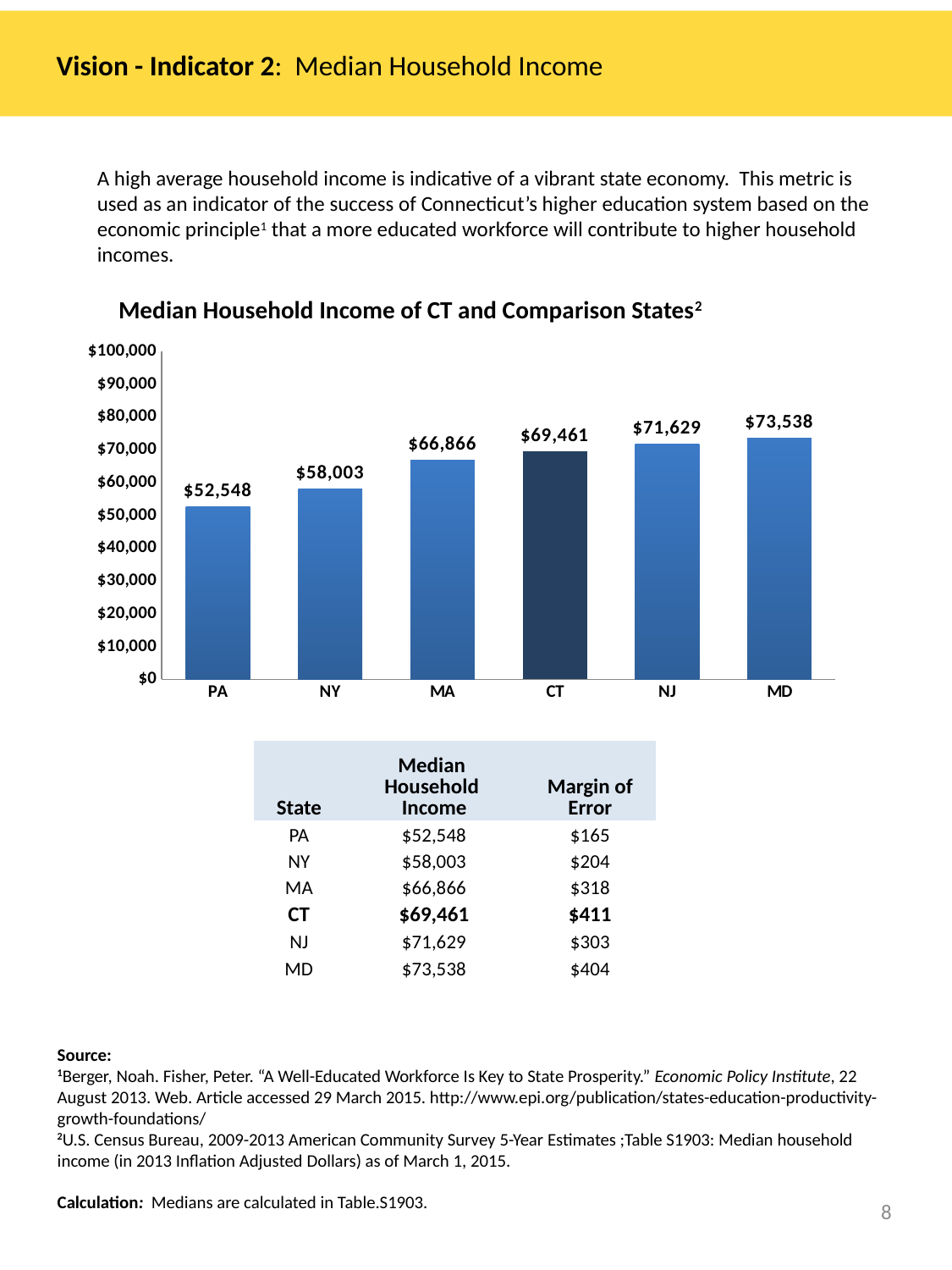
What is the difference between the median household income of MD and CT? $4,077 Which state has the highest median household income in the chart? MD Do the median household income values rise or fall from PA to MD along the x axis? rise What kind of chart is used to show median household income? bar chart What is the difference between the median household income of NY and PA? $5,455 What is the median household income for PA in the chart? $52,548 Which has a higher median household income, MA or NJ? NJ Is the median household income for MA greater or less than $60,000? greater What is the median household income for CT in the chart? $69,461 Which state has the lowest median household income in the chart? PA How many states are shown in the chart? 6 Which state's bar is shown in a darker colour than the others? CT